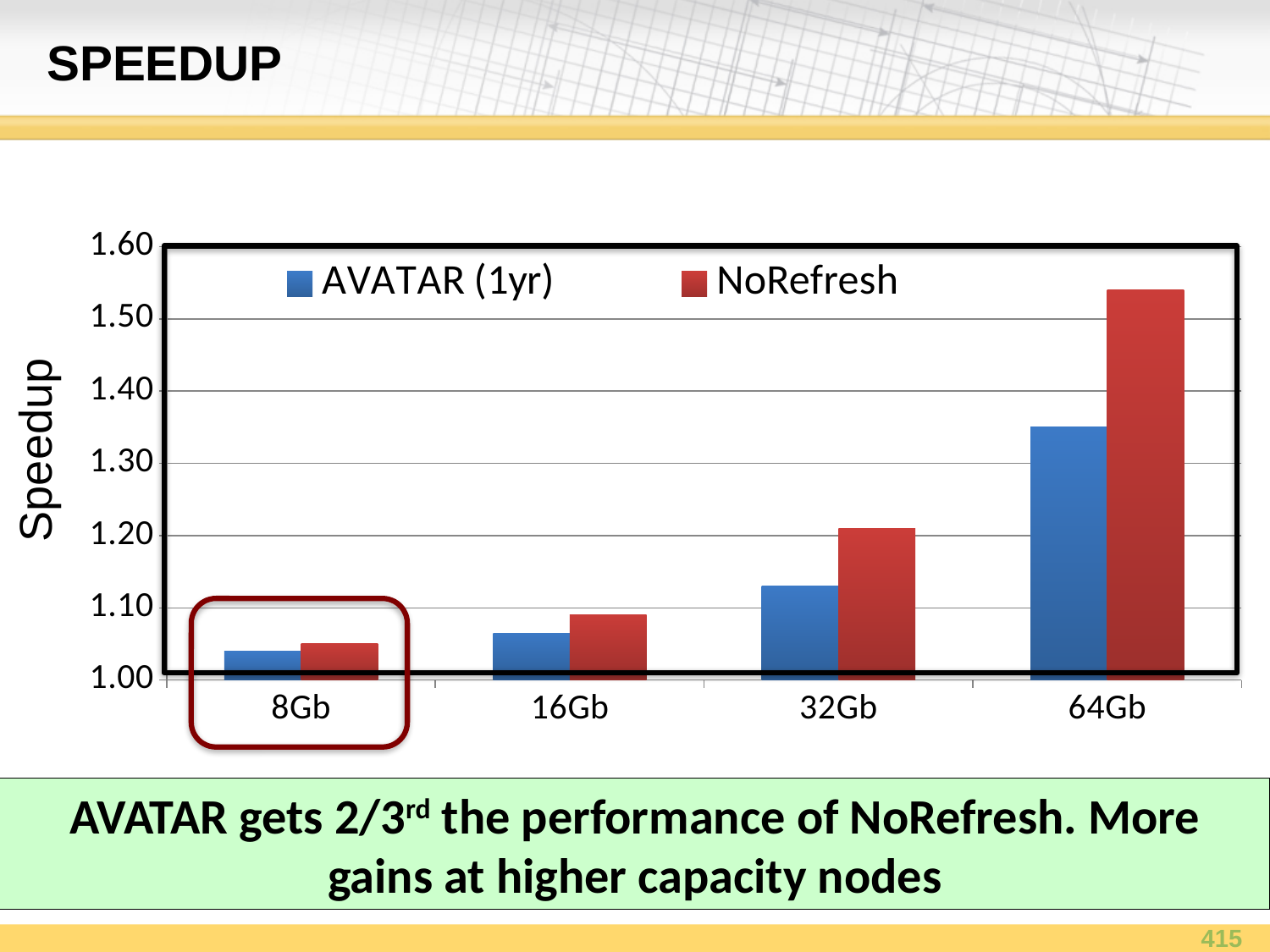
Is the NoRefresh speedup at 64Gb greater or less than 1.50? greater Which capacity has the highest AVATAR (1yr) speedup? 64Gb Is the AVATAR (1yr) speedup at 64Gb greater or less than 1.40? less Which capacity has the highest NoRefresh speedup? 64Gb What kind of chart is shown on the slide? bar chart Do the NoRefresh speedup values rise or fall as capacity increases from 8Gb to 64Gb? rise Is the AVATAR (1yr) speedup at 32Gb greater or less than 1.10? greater At 64Gb, which series has the larger speedup, AVATAR (1yr) or NoRefresh? NoRefresh How many capacity categories are shown on the x axis? 4 How many series does the legend list? 2 Which capacity has the lowest NoRefresh speedup? 8Gb